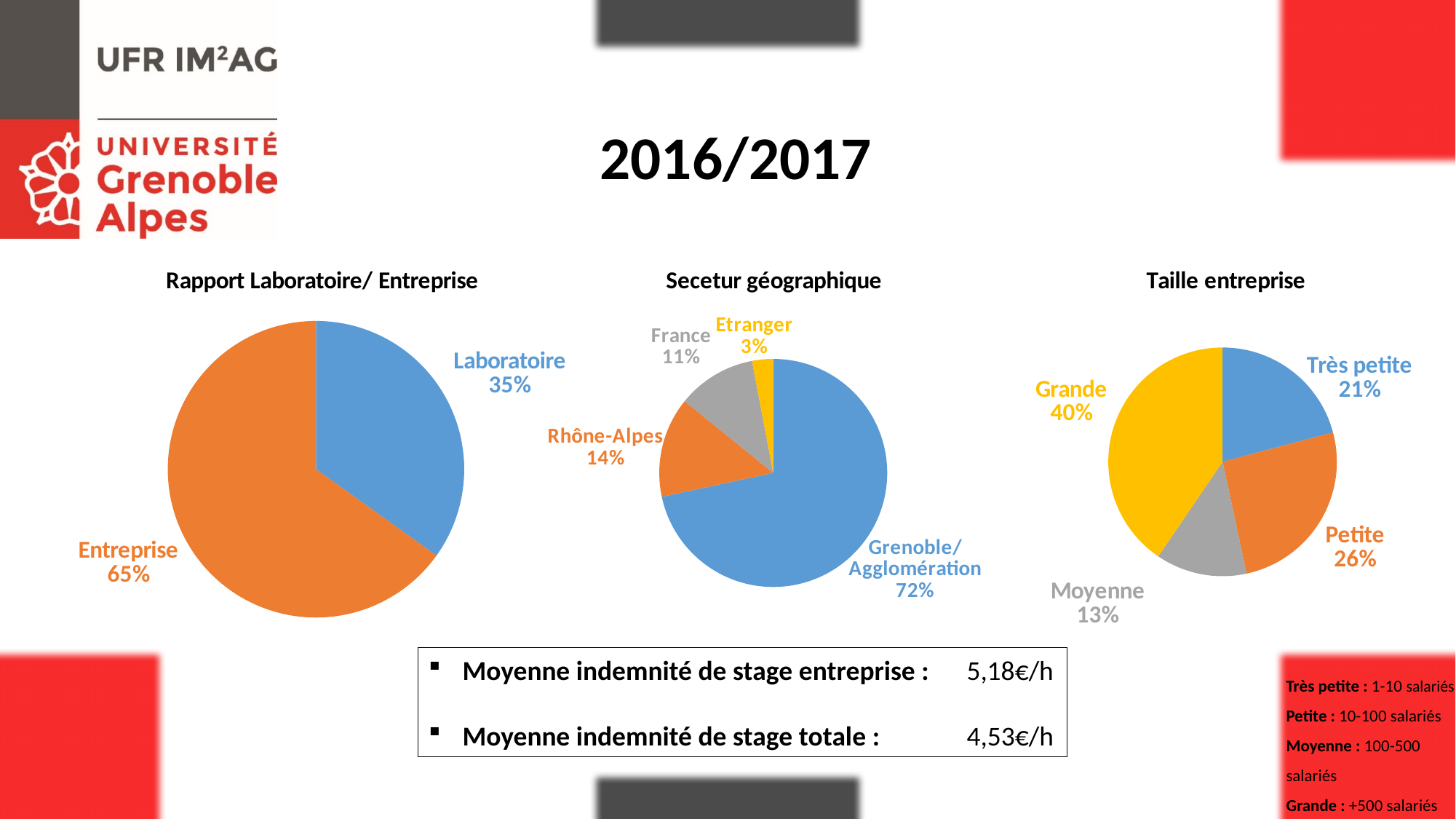
In the 'Secetur géographique' chart, which is larger, Rhône-Alpes or France? Rhône-Alpes In the 'Secetur géographique' chart, how many categories are shown? 4 In the 'Taille entreprise' chart, what is the difference between the Petite and Moyenne shares? 13% In the 'Taille entreprise' chart, which category has the largest share? Grande In the 'Taille entreprise' chart, what share does Grande have? 40% In the 'Rapport Laboratoire/ Entreprise' chart, what share does Laboratoire have? 35% In the 'Rapport Laboratoire/ Entreprise' chart, what is the difference between the Entreprise and Laboratoire shares? 30% In the 'Rapport Laboratoire/ Entreprise' chart, what share does Entreprise have? 65% How many pie charts are shown on the slide? 3 In the 'Secetur géographique' chart, what share does Grenoble/Agglomération have? 72% In the 'Secetur géographique' chart, which category has the smallest share? Etranger What kind of chart is the 'Taille entreprise' chart? Pie chart